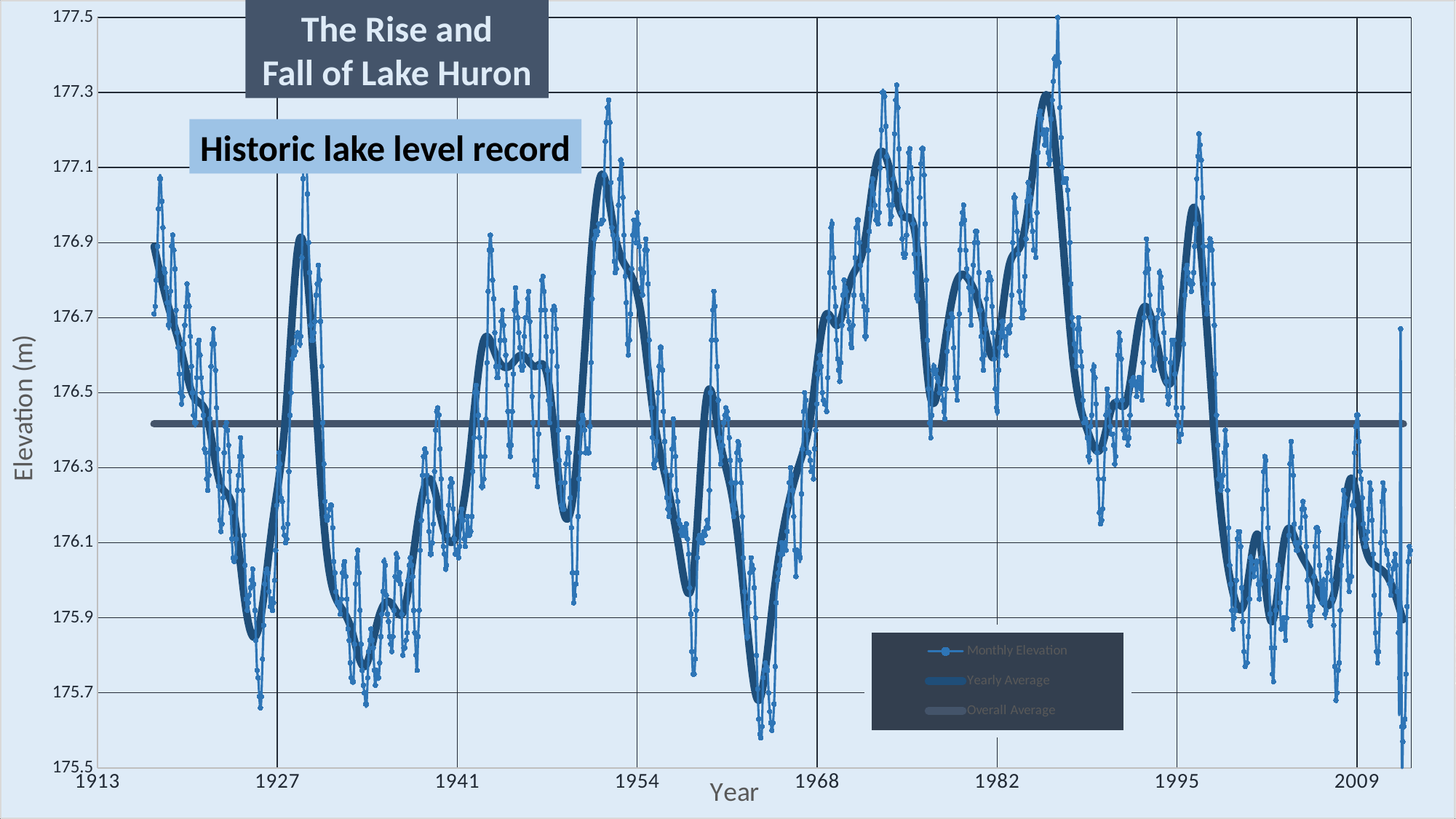
Is the lowest point of the Yearly Average around 1964 greater or less than 175.9? less Is the Overall Average line greater or less than 176.3? greater Is the Overall Average line greater or less than 176.5? less What kind of chart is shown on the slide? line chart Which is higher, the Yearly Average peak around 1986 or the Yearly Average peak around 1952? the peak around 1986 Does the Yearly Average generally rise or fall between 1964 and 1973? rise How many series does the legend list? 3 Does the Yearly Average generally rise or fall between 1986 and 2009? fall What is the title shown at the top of the slide? The Rise and Fall of Lake Huron What is the label on the y axis? Elevation (m)